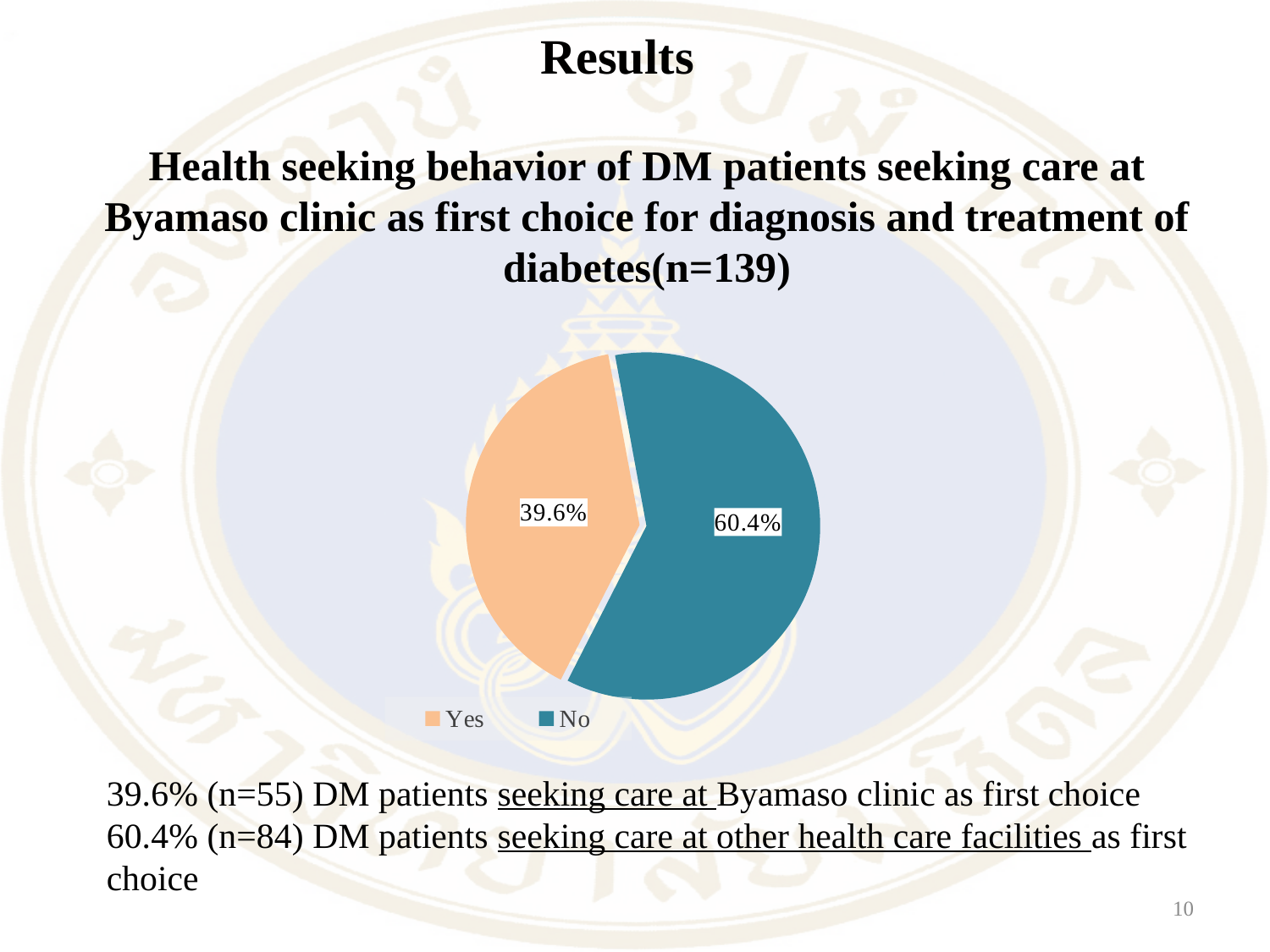
What is the sample size (n) stated in the chart's title? 139 Which is larger, the "Yes" slice or the "No" slice? No How many slices does the pie chart have? 2 What percentage of the pie is the "Yes" slice? 39.6% How many entries does the legend list? 2 What share of the pie does the "No" slice represent? 60.4% What kind of chart is shown on the slide? pie chart What is the difference in percentage points between the "No" slice and the "Yes" slice? 20.8 Which slice of the pie is the smallest? Yes What colour is the "Yes" slice in the pie chart? orange Which slice of the pie is the largest? No What percentage of the pie is the "No" slice? 60.4%